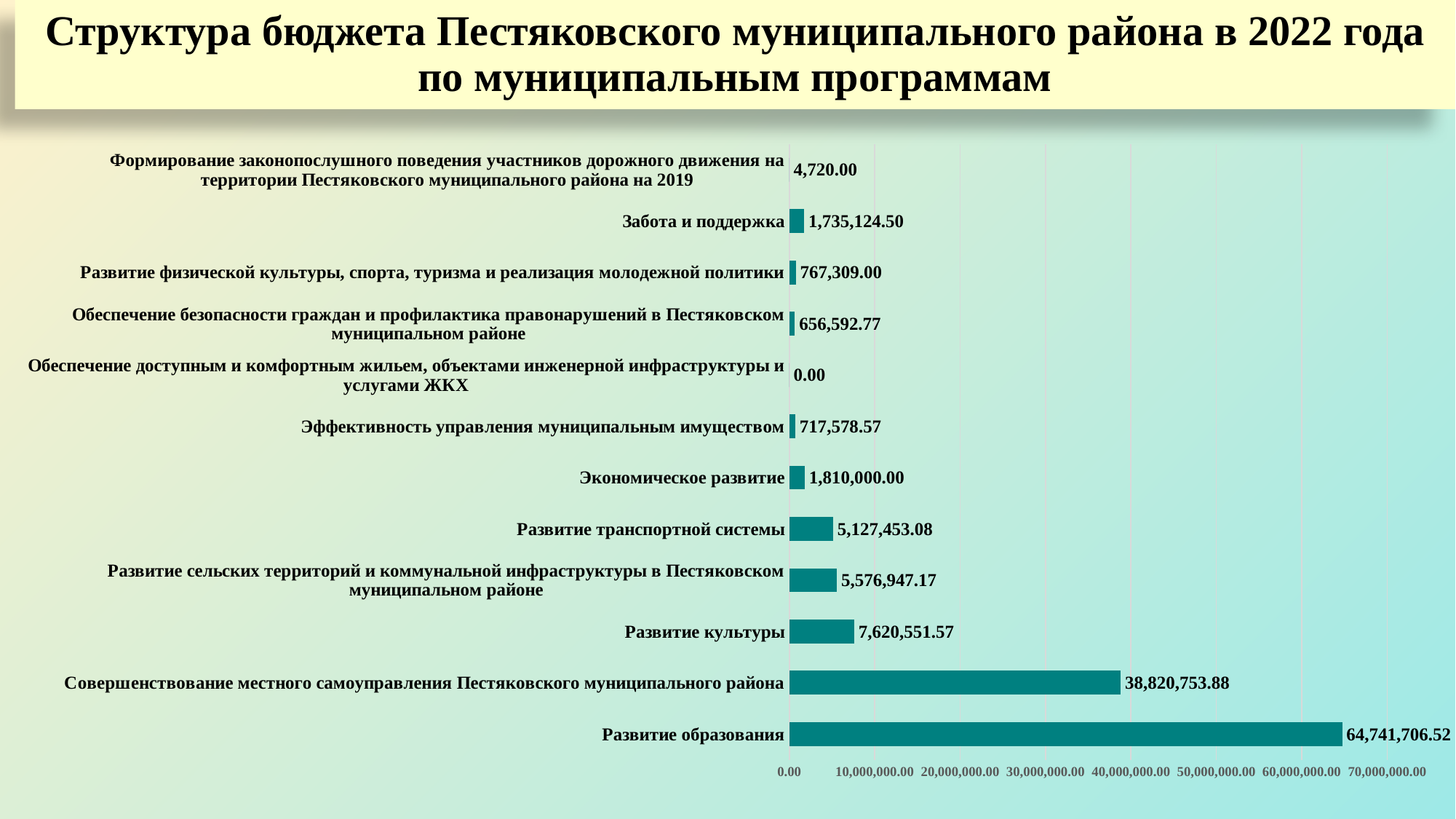
How many categories are shown in the chart? 12 What kind of chart is shown on the slide? bar chart Is the value for Совершенствование местного самоуправления Пестяковского муниципального района greater or less than 30,000,000.00? greater What is the value for Совершенствование местного самоуправления Пестяковского муниципального района? 38,820,753.88 Which is larger: the value for Развитие транспортной системы or the value for Развитие сельских территорий и коммунальной инфраструктуры в Пестяковском муниципальном районе? Развитие сельских территорий и коммунальной инфраструктуры в Пестяковском муниципальном районе What is the difference between the values for Развитие образования and Совершенствование местного самоуправления Пестяковского муниципального района? 25,920,952.64 What is the value for Развитие культуры? 7,620,551.57 What is the value for Забота и поддержка? 1,735,124.50 Which category has the lowest value? Обеспечение доступным и комфортным жильем, объектами инженерной инфраструктуры и услугами ЖКХ What is the value for Развитие образования? 64,741,706.52 Which category has the highest value? Развитие образования What is the value for Экономическое развитие? 1,810,000.00